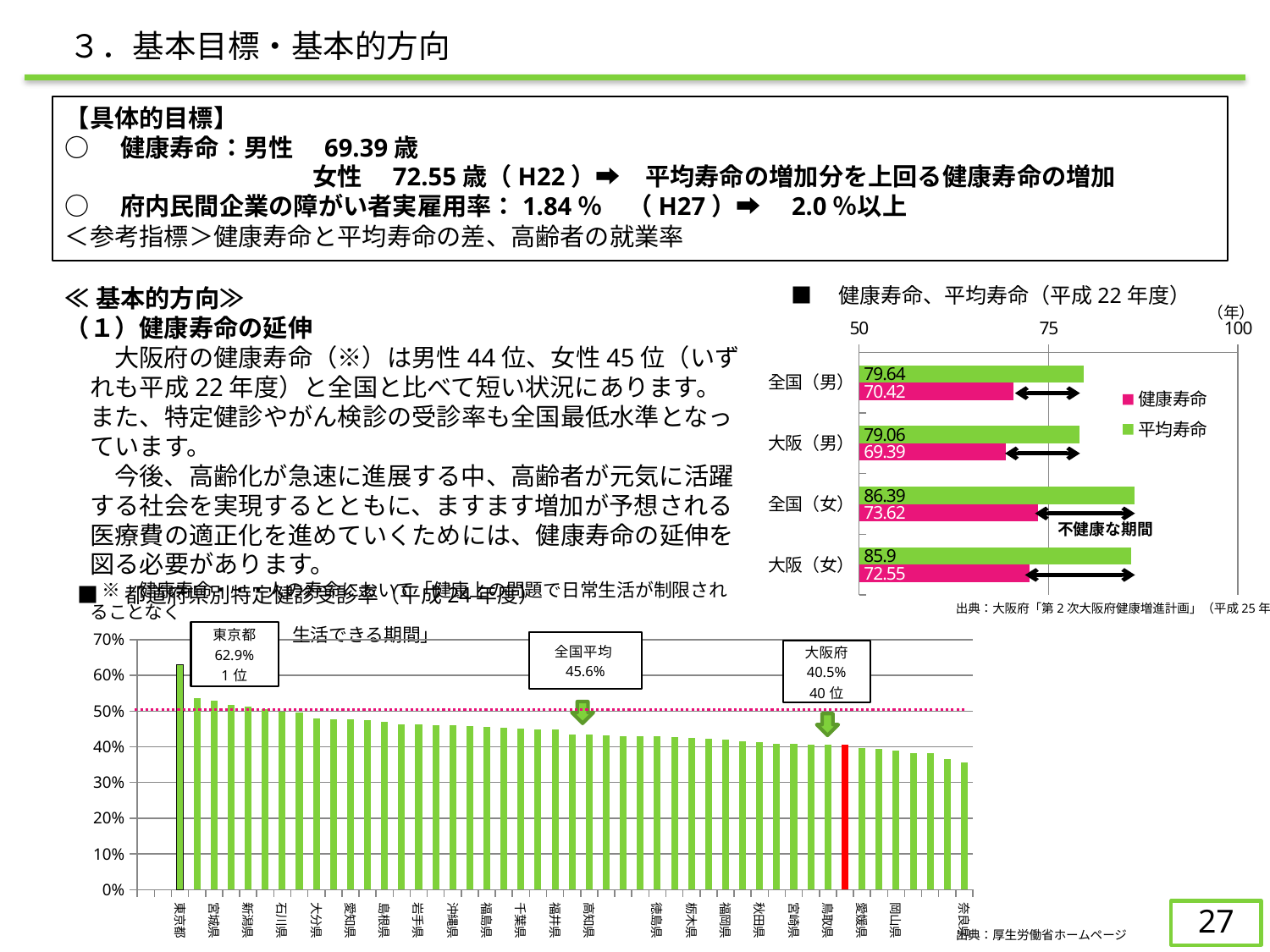
In the chart titled 健康寿命、平均寿命（平成22年度）, what is the 平均寿命 value for 大阪（女）? 85.9 In the bottom chart titled 都道府県別特定健診受診率（平成24年度）, what is the value for 大阪府? 40.5% In the chart titled 健康寿命、平均寿命（平成22年度）, what colour represents 健康寿命? Pink In the chart titled 健康寿命、平均寿命（平成22年度）, what is the 平均寿命 value for 全国（男）? 79.64 In the bottom chart titled 都道府県別特定健診受診率（平成24年度）, what is the value for 東京都? 62.9% In the chart titled 健康寿命、平均寿命（平成22年度）, what is the 健康寿命 value for 全国（女）? 73.62 In the chart titled 健康寿命、平均寿命（平成22年度）, what is the 健康寿命 value for 大阪（男）? 69.39 In the chart titled 健康寿命、平均寿命（平成22年度）, which is larger: the 健康寿命 for 全国（男） or for 大阪（男）? 全国（男） In the chart titled 健康寿命、平均寿命（平成22年度）, what is the difference between 平均寿命 and 健康寿命 for 大阪（女）? 13.35 In the chart titled 健康寿命、平均寿命（平成22年度）, which category has the lowest 健康寿命? 大阪（男） In the chart titled 健康寿命、平均寿命（平成22年度）, which category has the highest 平均寿命? 全国（女） In the chart titled 健康寿命、平均寿命（平成22年度）, how many series does the legend list? 2